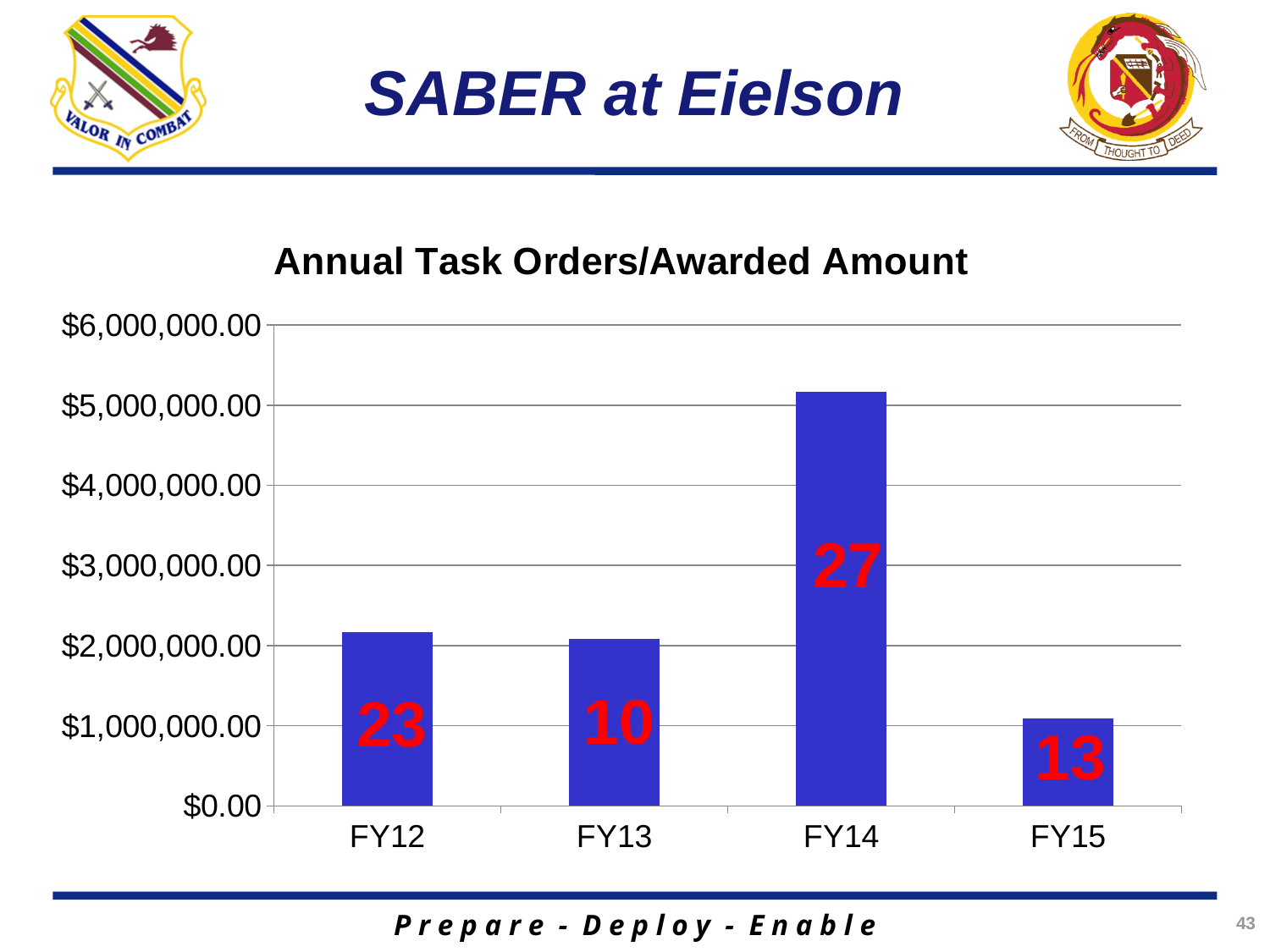
How many fiscal years are shown on the x axis of the chart? 4 Which fiscal year has the lowest awarded amount? FY15 What number is printed on the FY14 bar? 27 Is the awarded amount for FY15 greater or less than $2,000,000.00? less Which fiscal year has the smallest number printed on its bar? FY13 Is the awarded amount for FY14 greater or less than $4,000,000.00? greater What number is printed on the FY12 bar? 23 What number is printed on the FY15 bar? 13 What is the title of the chart? Annual Task Orders/Awarded Amount Which fiscal year has the highest awarded amount? FY14 What is the difference between the numbers printed on the FY14 and FY13 bars? 17 What kind of chart is shown on the slide? bar chart